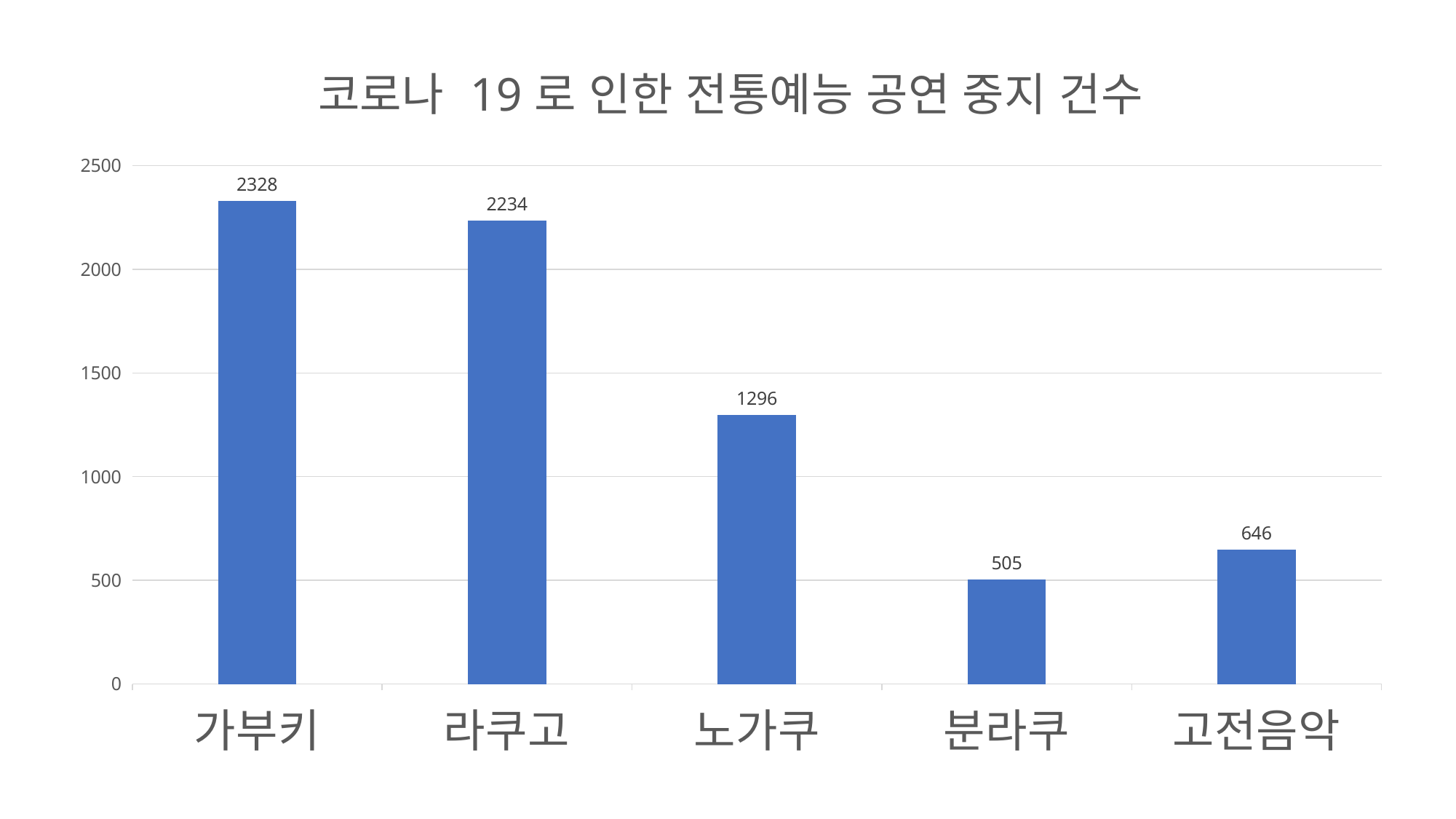
What is the difference between the values for 고전음악 and 분라쿠? 141 Which is larger, the value for 노가쿠 or the value for 고전음악? 노가쿠 What is the title of the chart? 코로나 19 로 인한 전통예능 공연 중지 건수 What is the value for 고전음악? 646 What is the value for 가부키? 2328 Which category has the lowest value? 분라쿠 How many categories are shown in the chart? 5 What is the value for 노가쿠? 1296 Which category has the highest value? 가부키 What kind of chart is shown on the slide? bar chart What is the value for 분라쿠? 505 What is the difference between the values for 가부키 and 라쿠고? 94